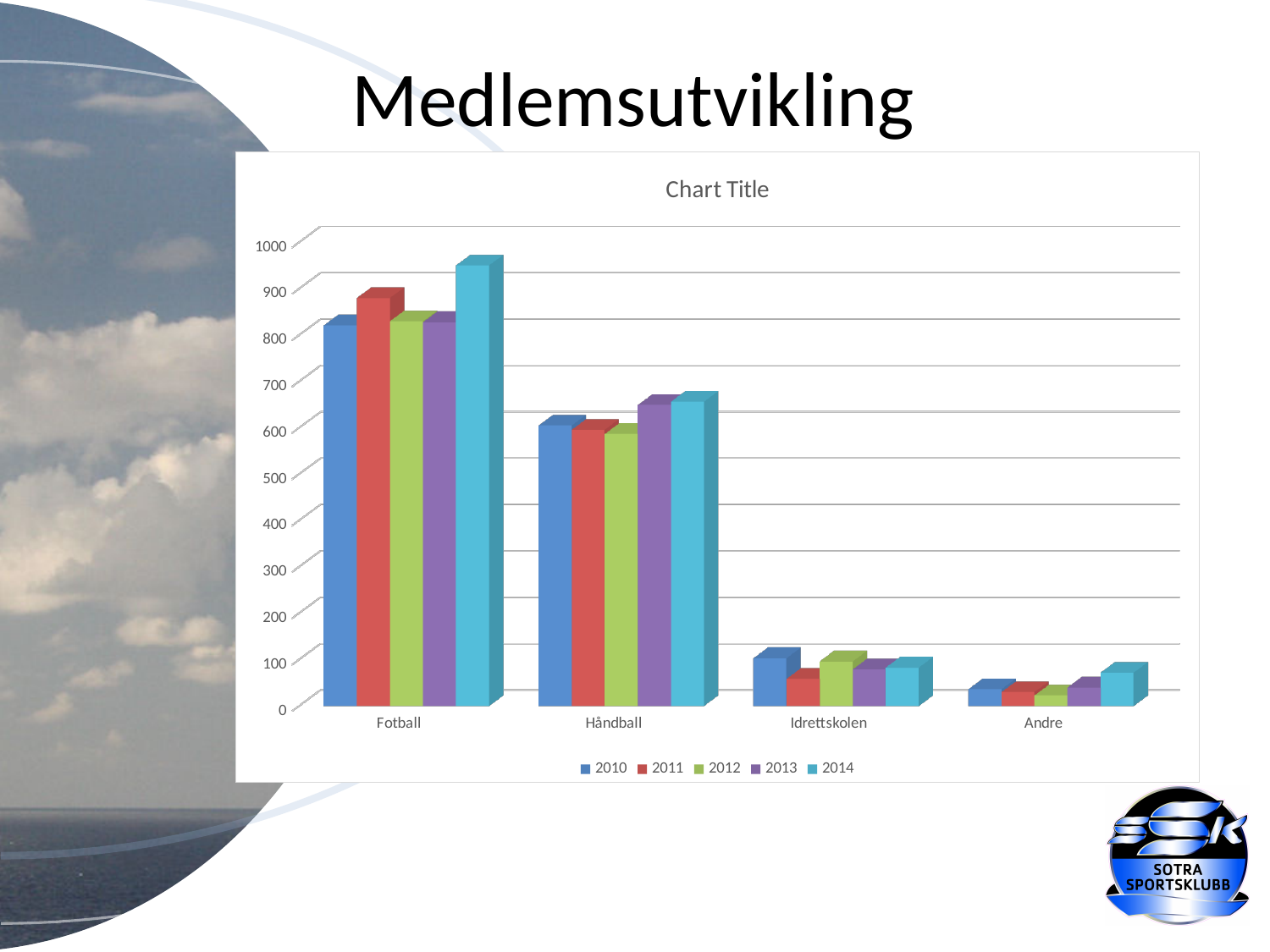
Which category has the highest values in the chart? Fotball Which category has the lowest values in the chart? Andre What kind of chart is shown on the slide? bar chart How many categories are shown on the x axis of the chart? 4 What title is printed above the chart's plot area? Chart Title Is the value for Andre in 2014 greater or less than 100? less Which is larger, the 2014 value for Fotball or the 2014 value for Håndball? Fotball How many series does the chart's legend list? 5 Is the value for Idrettskolen in 2010 greater or less than 200? less Is the value for Håndball in 2010 greater or less than 500? greater Within the Fotball category, which year has the tallest bar? 2014